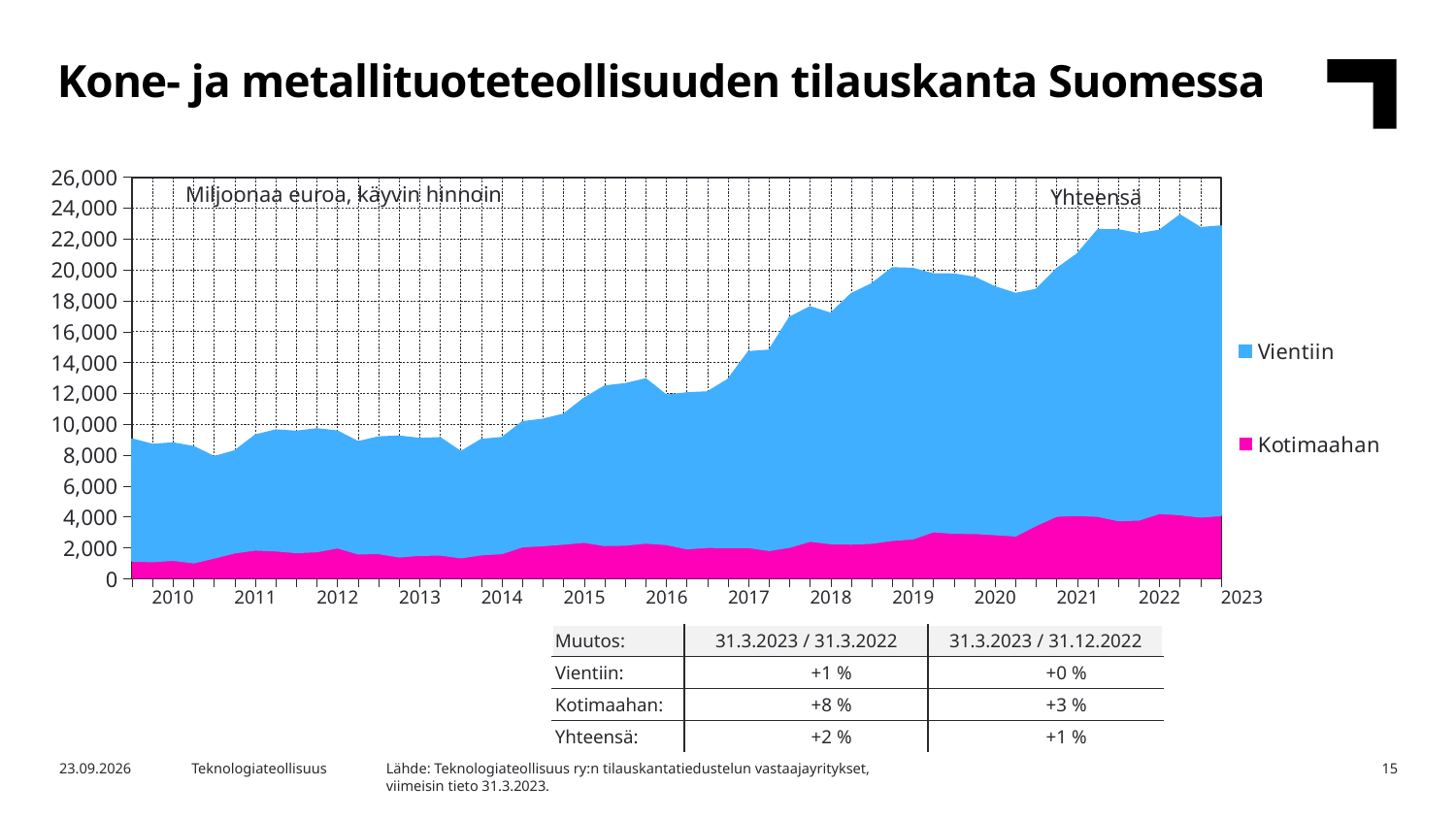
What are the two series named in the chart legend? Vientiin and Kotimaahan What unit label is shown inside the chart area at the top left? Miljoonaa euroa, käyvin hinnoin How many year labels are shown on the x axis of the chart? 14 Is the total order backlog in 2013 greater or less than 10,000? less Is the total order backlog (Yhteensä) in 2016 greater or less than 14,000? less Which series is larger throughout the chart, Vientiin or Kotimaahan? Vientiin Does the total order backlog generally rise or fall from 2010 to 2023? rise Is the Kotimaahan value at the start of 2010 greater or less than 2,000? less How many series does the chart legend list? 2 What kind of chart is shown on the slide? Stacked area chart